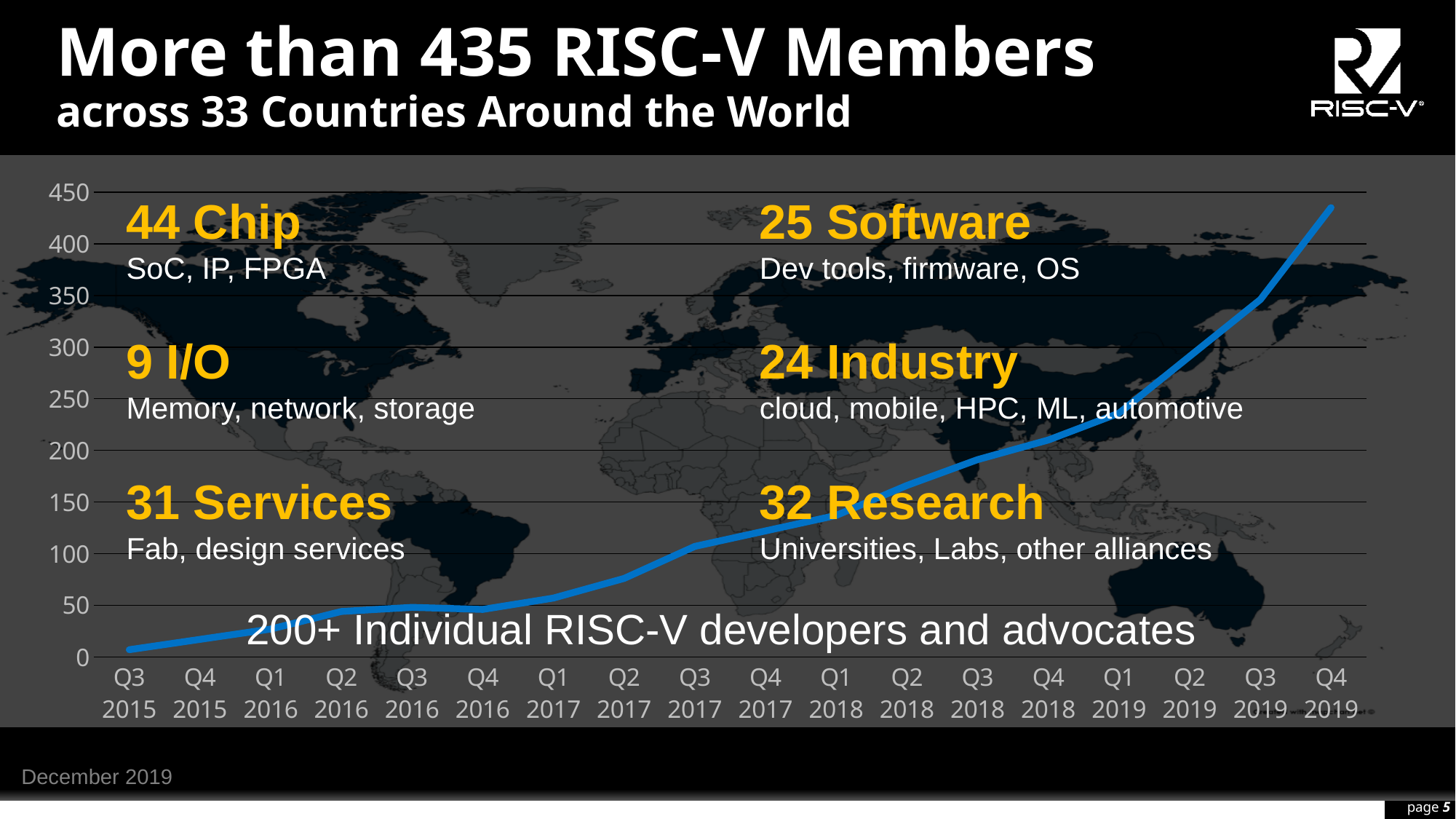
Which is larger, the value for Q3 2019 or the value for Q1 2018? Q3 2019 Is the value for Q2 2017 greater or less than 50? greater How many quarterly points are plotted along the x axis of the chart? 18 What is the highest tick label shown on the y axis of the chart? 450 Is the value for Q4 2019 greater or less than 400? greater Which quarter has the lowest value on the chart? Q3 2015 Is the value for Q2 2018 greater or less than 150? greater Does the plotted line rise or fall from Q3 2015 to Q4 2019? rise Which quarter has the highest value on the chart? Q4 2019 What kind of chart is shown on the slide? line chart